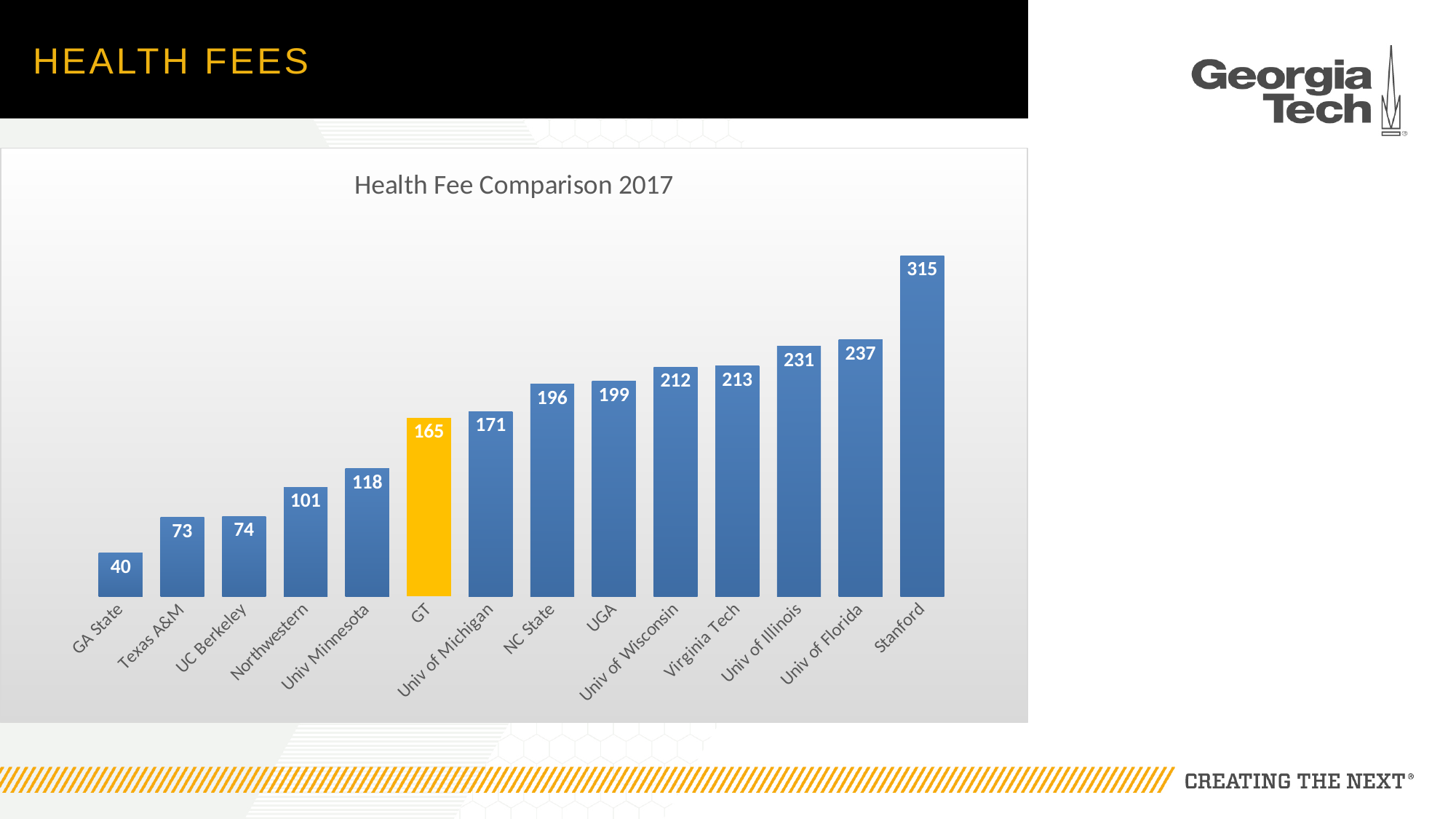
What is the health fee value for GA State? 40 Which institution has the highest health fee? Stanford What kind of chart is shown on the slide? Bar chart What is the health fee value for Univ of Wisconsin? 212 What is the health fee value for GT? 165 What is the title of the chart? Health Fee Comparison 2017 What is the difference between the health fees of Stanford and GT? 150 Do the values rise or fall from left to right along the x axis? Rise What is the difference between the health fees of Univ of Florida and Univ of Illinois? 6 Which has a higher health fee, NC State or Univ Minnesota? NC State How many institutions are shown in the chart? 14 Which institution has the lowest health fee? GA State